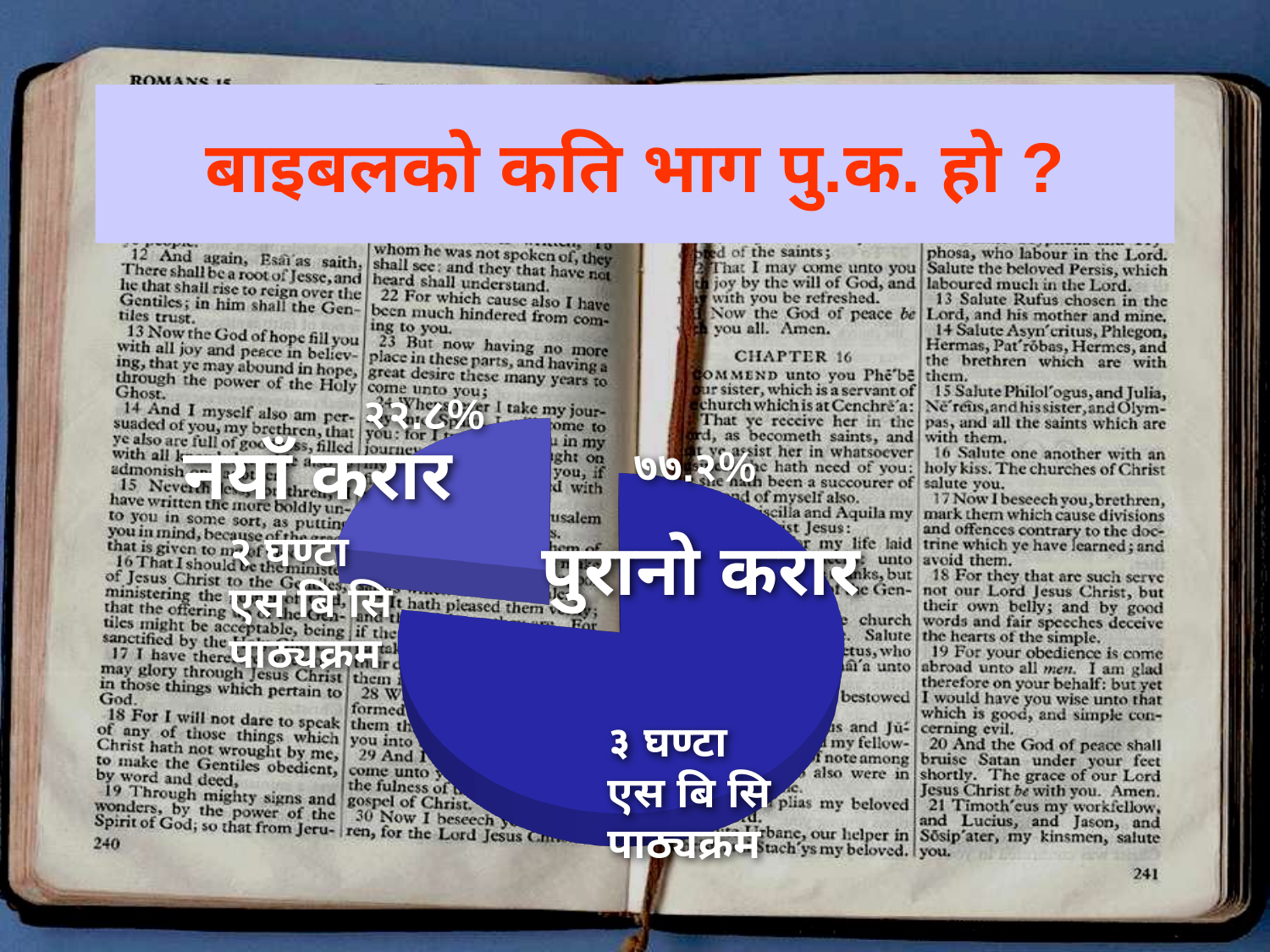
What is the title of the chart on the slide? बाइबलको कति भाग पु.क. हो ? What kind of chart is shown on the slide? pie chart Which slice of the pie chart is the smallest? नयाँ करार What percentage is shown for the पुरानो करार slice? ७७.२% Which slice of the pie chart is the largest? पुरानो करार Which is larger, the नयाँ करार slice or the पुरानो करार slice? पुरानो करार Which slice of the pie chart is pulled out (exploded) from the rest? नयाँ करार What share of the pie does the पुरानो करार slice represent? ७७.२% What percentage is shown for the नयाँ करार slice? २२.८% What is the difference in percentage points between the पुरानो करार slice and the नयाँ करार slice? ५४.४ How many slices does the pie chart have? 2